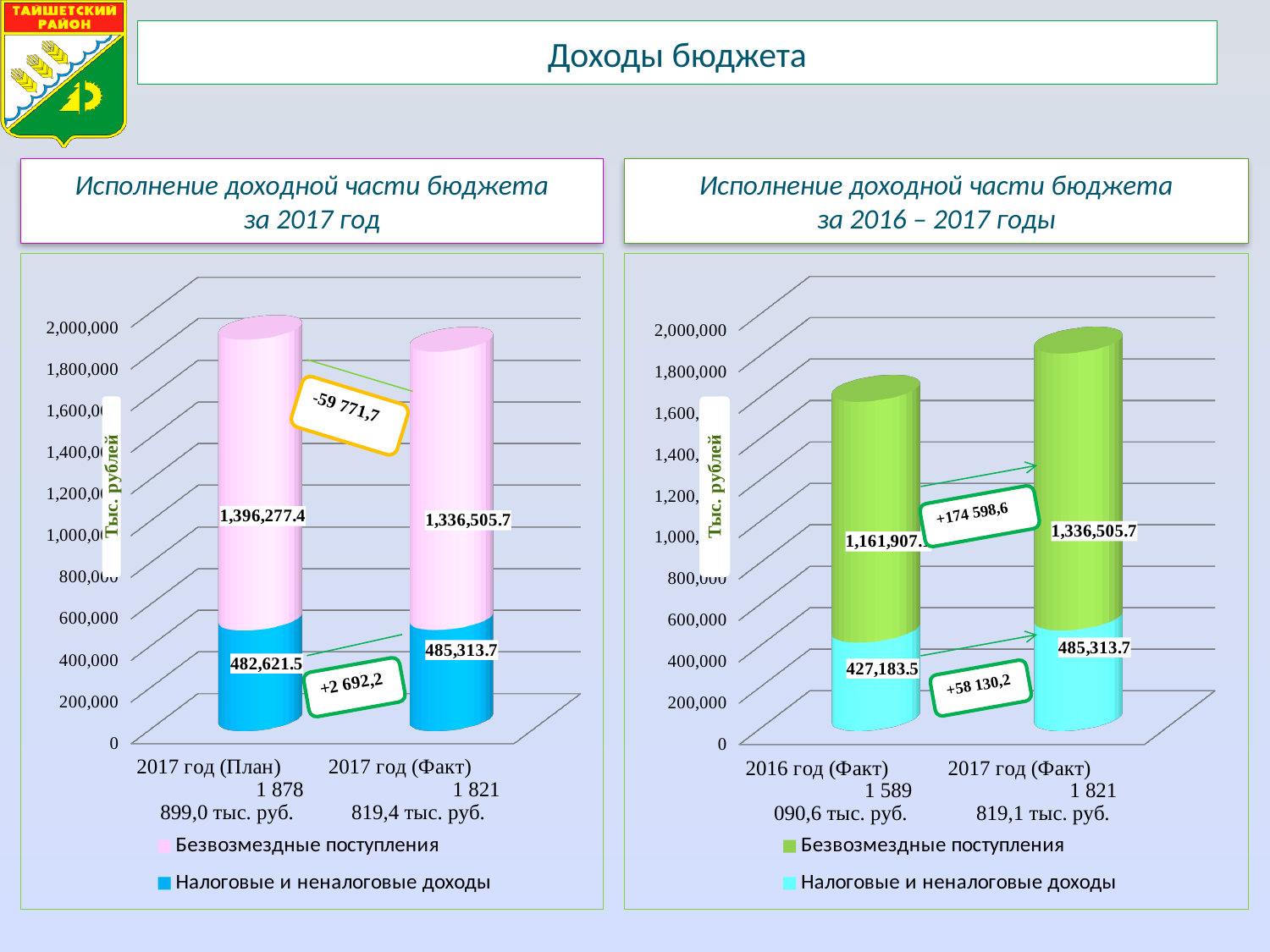
On the left chart (Исполнение доходной части бюджета за 2017 год), how many series does the legend list? 2 On the left chart (Исполнение доходной части бюджета за 2017 год), what total is shown for the 2017 год (Факт) bar? 1 821 819,4 тыс. руб. On the left chart (Исполнение доходной части бюджета за 2017 год), what is the difference between Безвозмездные поступления for 2017 год (План) and 2017 год (Факт)? 59,771.7 On the right chart (Исполнение доходной части бюджета за 2016 – 2017 годы), do the values of Безвозмездные поступления rise or fall from 2016 to 2017? rise On the right chart (Исполнение доходной части бюджета за 2016 – 2017 годы), what is the difference in Налоговые и неналоговые доходы between 2017 год (Факт) and 2016 год (Факт)? 58,130.2 On the left chart (Исполнение доходной части бюджета за 2017 год), what is the value of Налоговые и неналоговые доходы for 2017 год (Факт)? 485,313.7 On the right chart (Исполнение доходной части бюджета за 2016 – 2017 годы), what is the value of Налоговые и неналоговые доходы for 2016 год (Факт)? 427,183.5 On the left chart (Исполнение доходной части бюджета за 2017 год), which is larger: Налоговые и неналоговые доходы for 2017 год (План) or for 2017 год (Факт)? 2017 год (Факт) On the right chart (Исполнение доходной части бюджета за 2016 – 2017 годы), what is the value of Безвозмездные поступления for 2017 год (Факт)? 1,336,505.7 On the right chart (Исполнение доходной части бюджета за 2016 – 2017 годы), how many categories are shown on the x axis? 2 What kind of chart is the left chart (Исполнение доходной части бюджета за 2017 год)? stacked bar chart On the left chart (Исполнение доходной части бюджета за 2017 год), what is the value of Безвозмездные поступления for 2017 год (План)? 1,396,277.4